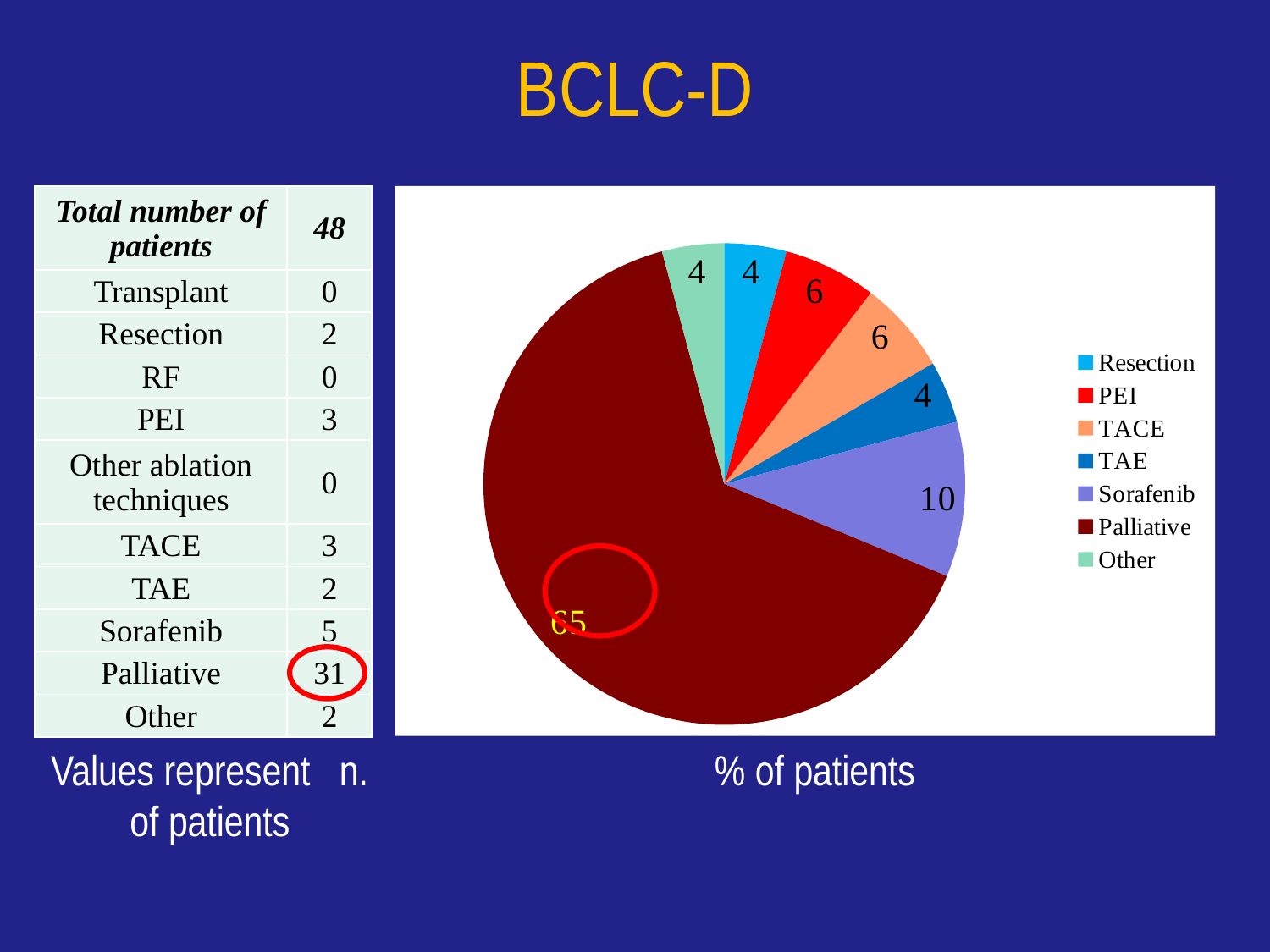
What is the value shown for the Sorafenib slice of the pie chart? 10 What is the value shown for the TAE slice of the pie chart? 4 What is the value shown for the PEI slice of the pie chart? 6 What kind of chart is shown on the slide? pie chart Which category has the largest slice in the pie chart? Palliative What colour is the Palliative slice in the pie chart? dark red Which is larger in the pie chart, the Sorafenib slice or the PEI slice? Sorafenib What is the difference between the Palliative value and the Sorafenib value in the pie chart? 55 How many entries does the pie chart's legend list? 7 How many slices does the pie chart have? 7 What is the difference between the Sorafenib value and the TACE value in the pie chart? 4 What is the value shown for the Palliative slice of the pie chart? 65